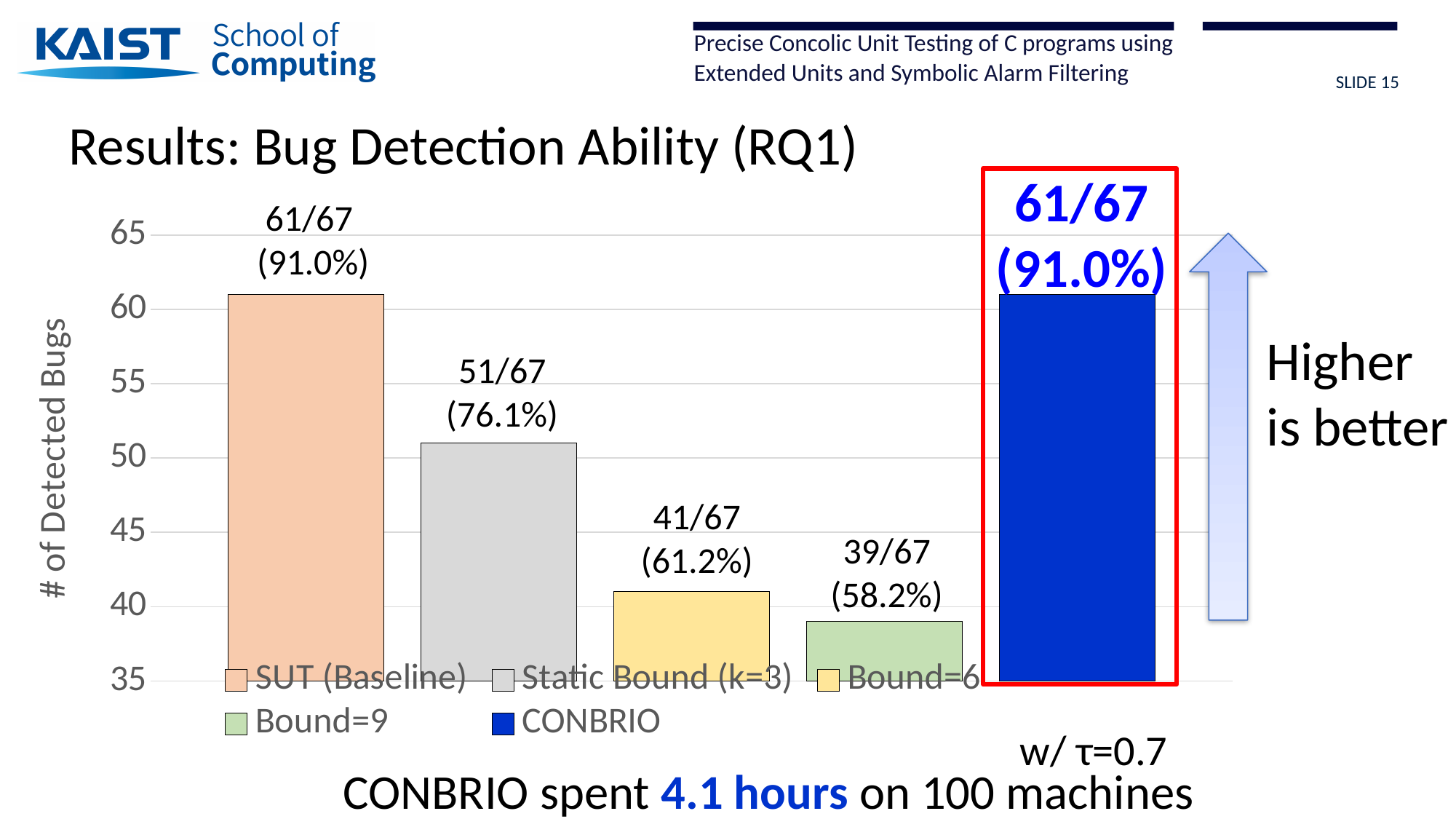
Which series has the lowest number of detected bugs? Bound=9 What value is labelled on the Static Bound (k=3) bar? 51/67 (76.1%) Which detected more bugs, Bound=6 or Bound=9? Bound=6 How many bars are plotted in the chart? 5 How many more bugs did SUT (Baseline) detect than Bound=9? 22 How many more bugs did CONBRIO detect than Static Bound (k=3)? 10 How many series does the legend list? 5 What is the labelled value for the Bound=9 bar? 39/67 (58.2%) What kind of chart is shown on the slide? bar chart What value is labelled on the CONBRIO bar? 61/67 (91.0%) How many bugs did Bound=6 detect, as labelled on the chart? 41/67 (61.2%) Is the value for Static Bound (k=3) greater or less than 50? greater